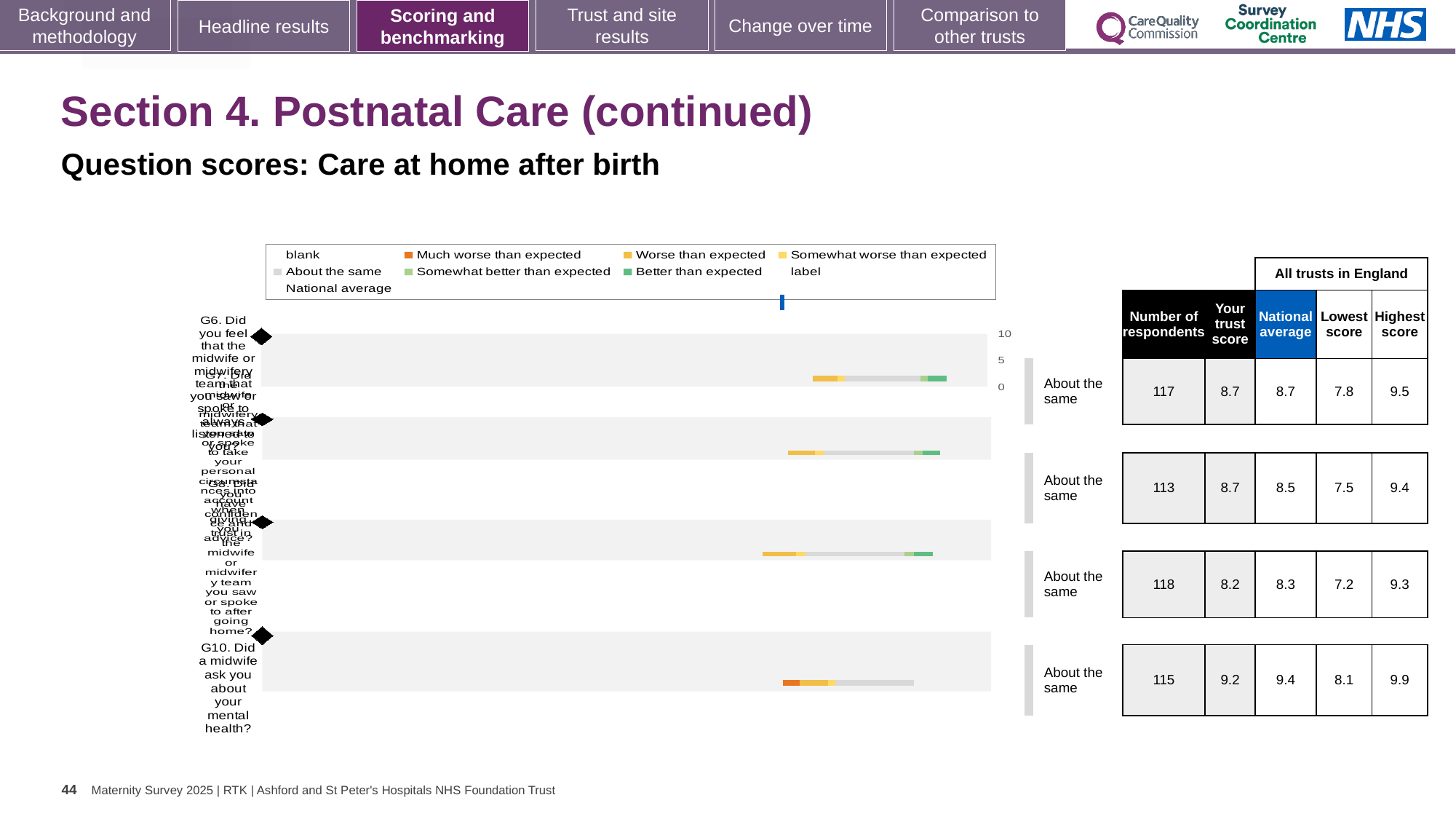
In the table, what is the highest score among all trusts in England for G10 'Did a midwife ask you about your mental health?' 9.9 For G10, which is larger: the trust score or the national average? national average In the table, what is 'Your trust score' for G10 'Did a midwife ask you about your mental health?' 9.2 Which colour in the legend represents 'Much worse than expected'? orange How many questions (bars) are plotted in the chart? 4 What kind of chart is shown on the slide? bar chart In the table, what is the number of respondents for G10 'Did a midwife ask you about your mental health?' 115 What is the lowest 'Your trust score' value shown in the table? 8.2 For G10, what is the difference between the national average and the trust score? 0.2 Which colour in the legend represents 'Better than expected'? green In the table, what is the national average for G10 'Did a midwife ask you about your mental health?' 9.4 What is the highest 'Your trust score' value shown in the table? 9.2